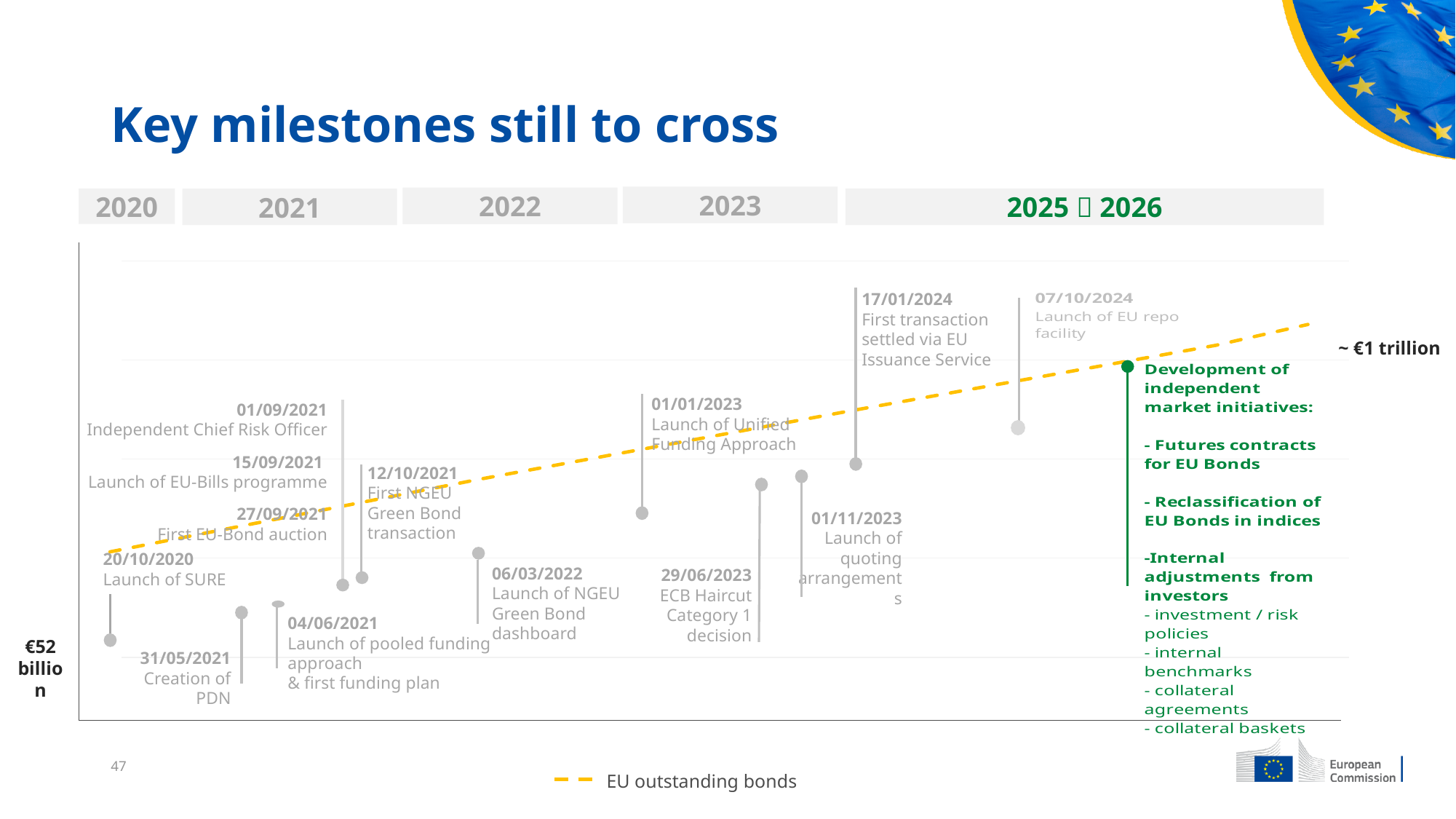
How many year period headers are shown across the top of the timeline? 5 On what date was the first EU-Bond auction? 27/09/2021 What is the name of the series shown in the legend? EU outstanding bonds What kind of chart is used to show EU outstanding bonds on this slide? line chart What value is labelled at the end of the EU outstanding bonds line? ~ €1 trillion Which milestone is dated 01/01/2023? Launch of Unified Funding Approach Which milestone is dated 17/01/2024? First transaction settled via EU Issuance Service Does the EU outstanding bonds line rise or fall from 2020 to 2025-2026? rise On what date was the EU repo facility launched according to the timeline? 07/10/2024 How many series does the legend list? 1 Which milestone is dated 20/10/2020? Launch of SURE What value is labelled at the start of the EU outstanding bonds line in 2020? €52 billion